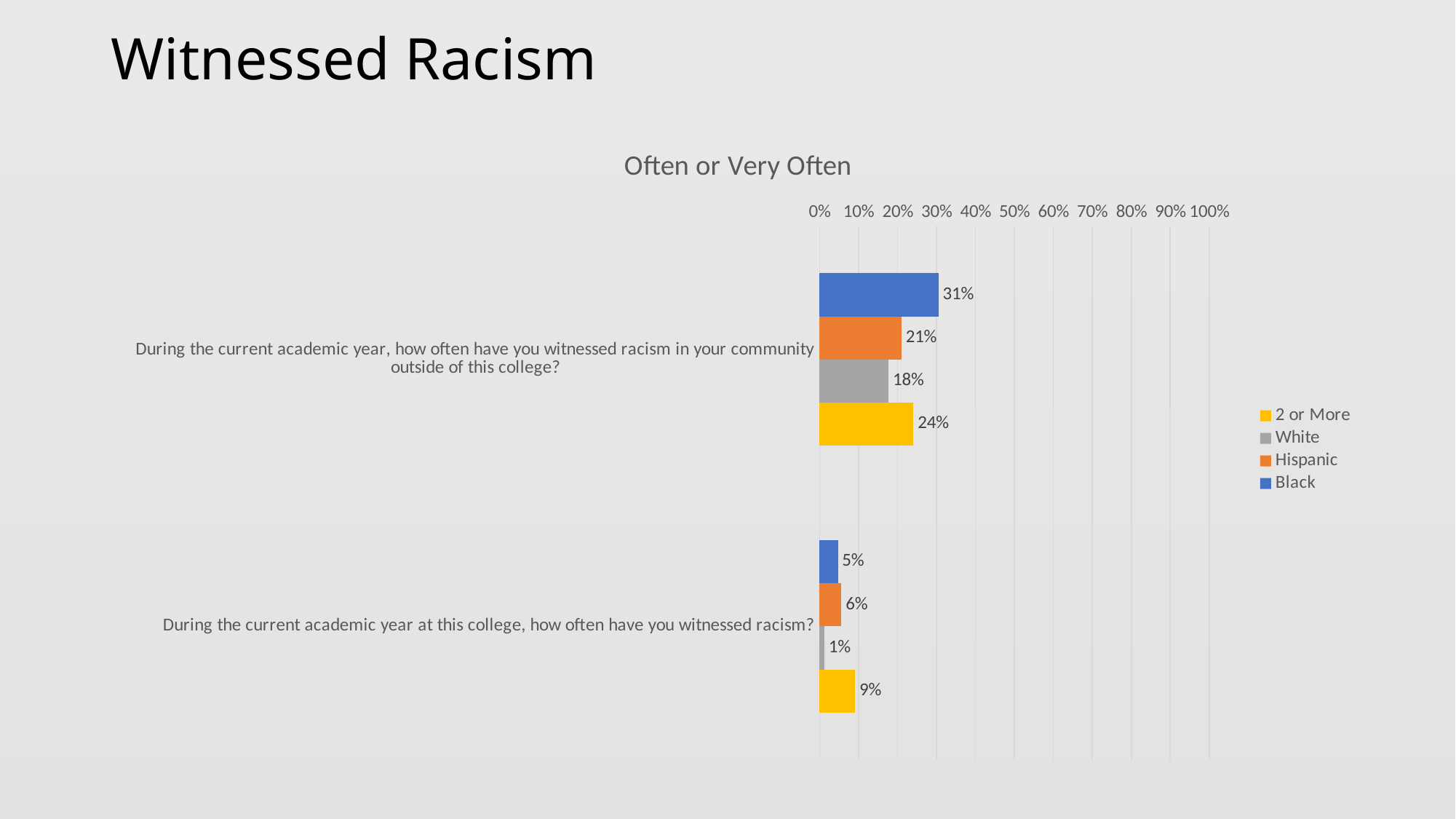
Which colour represents the Hispanic series in the chart? Orange How many series does the legend list? 4 What is the value for Hispanic respondents for the question about witnessing racism at this college? 6% What is the difference between the Black and White values for the question about witnessing racism in the community outside of this college? 13% What is the value for Black respondents for the question about witnessing racism in the community outside of this college? 31% Which group has the lowest value for the question about witnessing racism at this college? White What is the value for White respondents for the question about witnessing racism at this college? 1% What is the value for the '2 or More' group for the question about witnessing racism in the community outside of this college? 24% Which group has the highest value for the question about witnessing racism in the community outside of this college? Black For the question about witnessing racism at this college, which is larger: the value for '2 or More' or the value for Black? 2 or More What is the title of the chart? Often or Very Often What kind of chart is shown on the slide? Bar chart